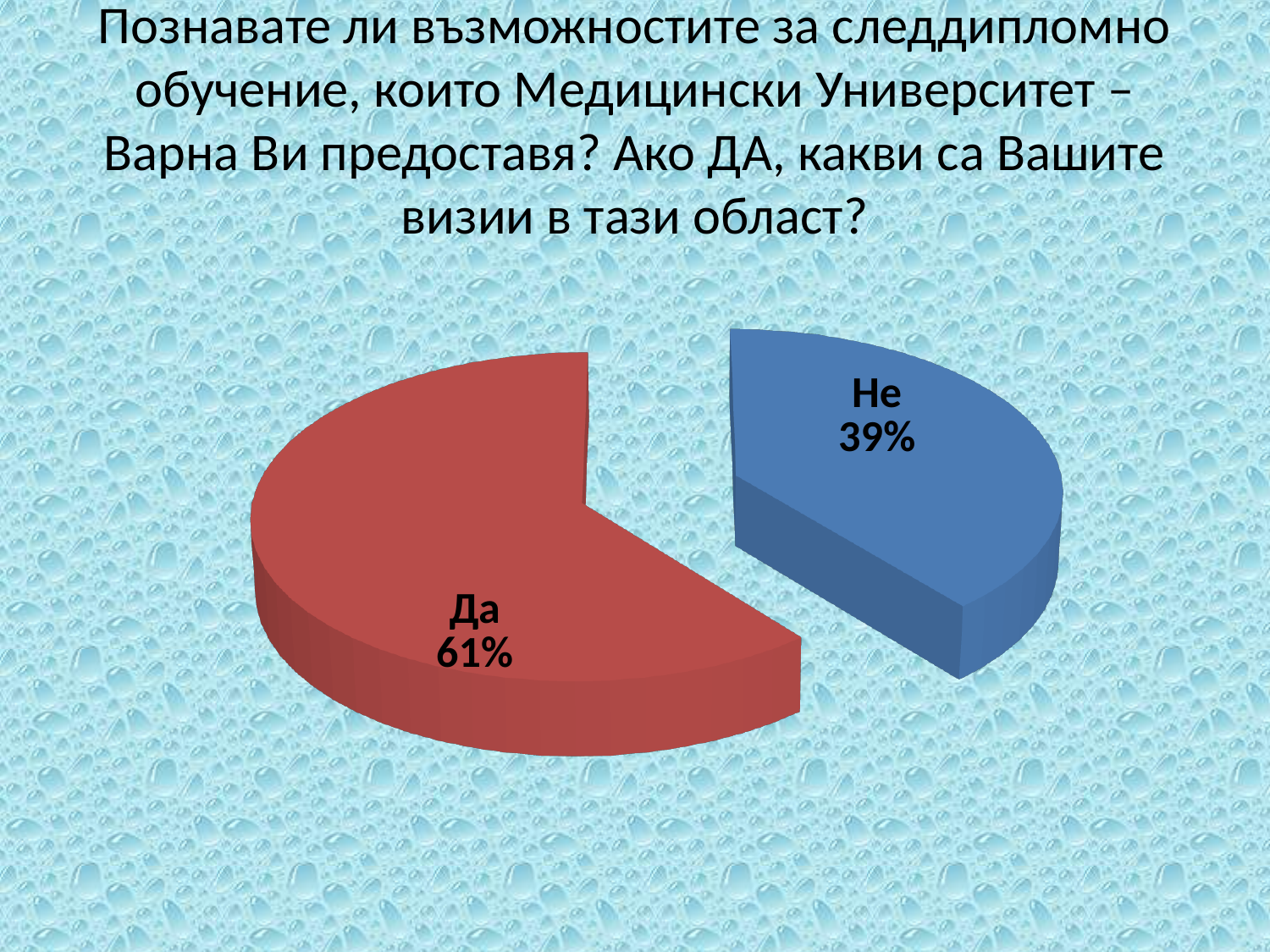
What share of the pie does the "Да" slice represent? 61% How many slices does the pie chart have? 2 Which slice is the smallest in the pie chart? Не What share of the pie does the "Не" slice represent? 39% What colour is the "Не" slice? Blue Which slice is the largest in the pie chart? Да What is the difference in percentage points between the "Да" and "Не" slices? 22 percentage points What colour is the "Да" slice? Red What is the total of the two slices shown in the pie chart? 100% What kind of chart is shown on the slide? Pie chart Which is larger, the "Да" slice or the "Не" slice? Да